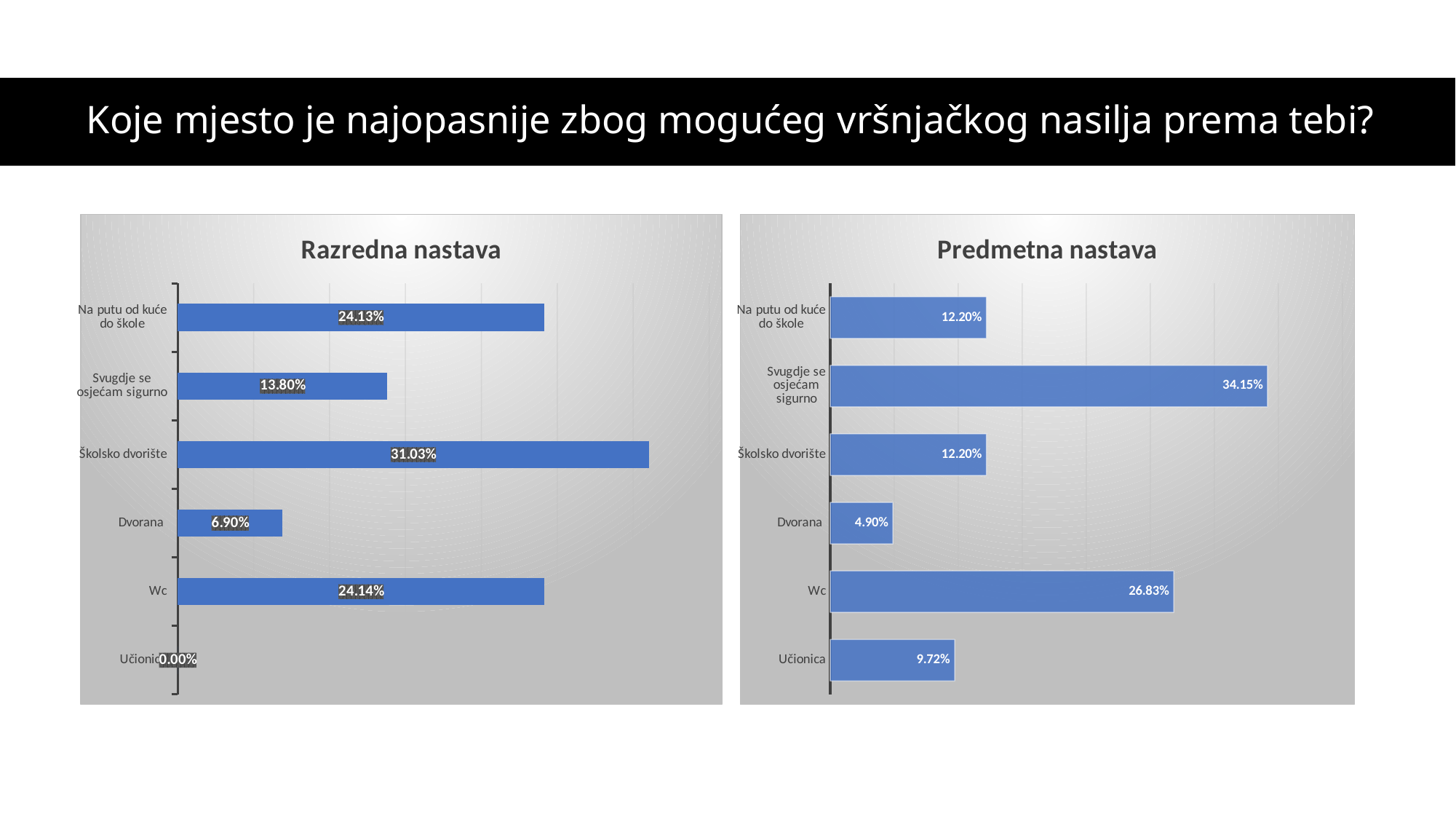
In the 'Razredna nastava' chart, what is the value for Učionica? 0.00% In the 'Razredna nastava' chart, which is larger: the value for Svugdje se osjećam sigurno or the value for Dvorana? Svugdje se osjećam sigurno In the 'Predmetna nastava' chart, which category has the highest value? Svugdje se osjećam sigurno In the 'Predmetna nastava' chart, which category has the lowest value? Dvorana In the 'Predmetna nastava' chart, which is larger: the value for Wc or the value for Na putu od kuće do škole? Wc In the 'Razredna nastava' chart, what is the difference between the values for Školsko dvorište and Dvorana? 24.13% In the 'Predmetna nastava' chart, what is the difference between the values for Svugdje se osjećam sigurno and Učionica? 24.43% What kind of chart is the 'Predmetna nastava' chart? Bar chart In the 'Razredna nastava' chart, what is the value for Školsko dvorište? 31.03% In the 'Predmetna nastava' chart, what is the value for Wc? 26.83% In the 'Razredna nastava' chart, which category has the highest value? Školsko dvorište How many categories are shown in the 'Razredna nastava' chart? 6